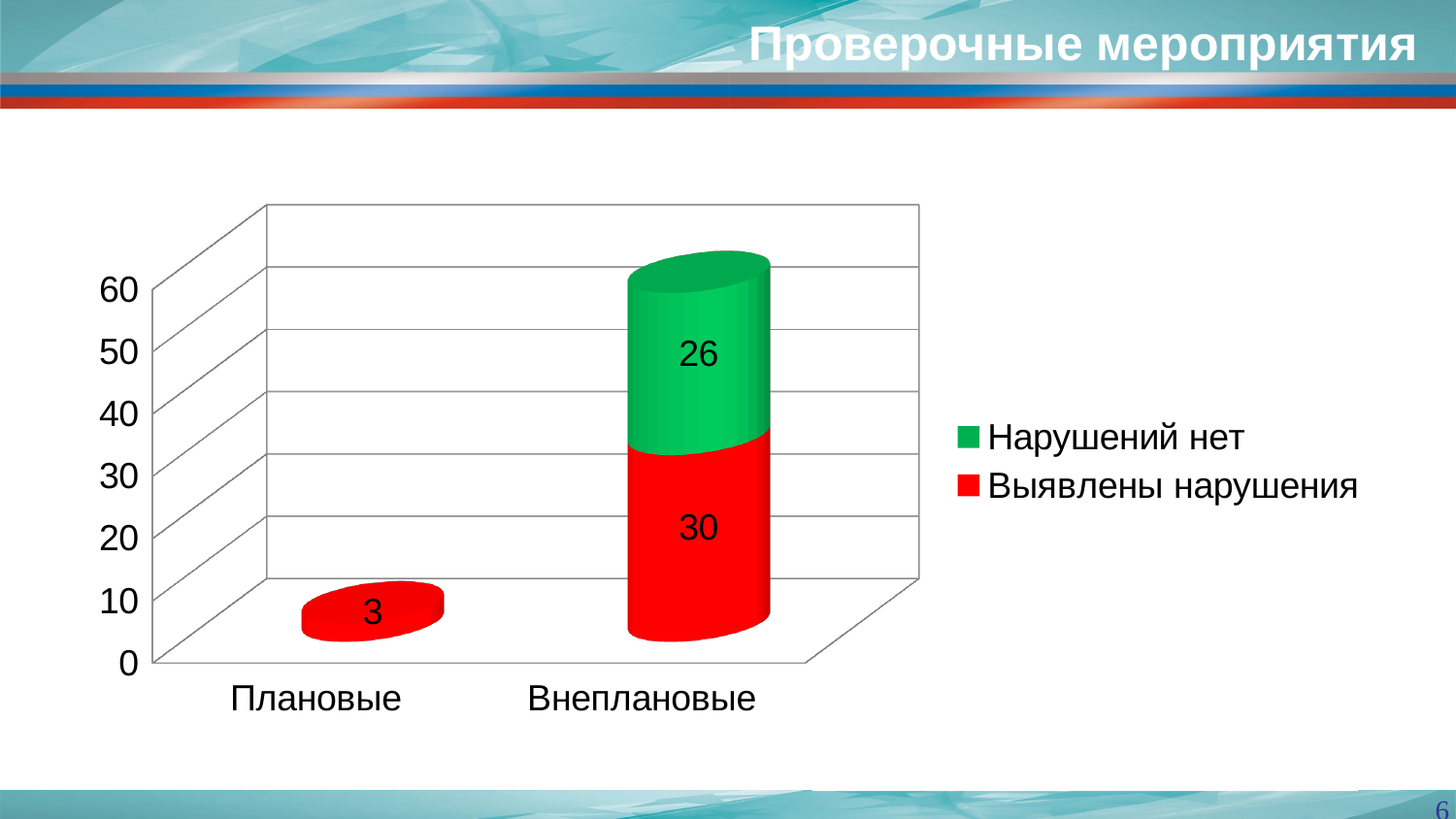
What is the value for "Нарушений нет" in the "Внеплановые" category? 26 What kind of chart is shown on the slide? Stacked bar chart Which category has the higher value for "Выявлены нарушения", "Плановые" or "Внеплановые"? Внеплановые How many series does the legend list? 2 Which colour represents "Нарушений нет" in the legend? Green What is the value for "Выявлены нарушения" in the "Плановые" category? 3 How many categories are shown on the x axis? 2 What is the value for "Выявлены нарушения" in the "Внеплановые" category? 30 Is the total for "Внеплановые" greater or less than 50? greater What is the total of the stacked bar for "Внеплановые"? 56 What is the difference between "Выявлены нарушения" and "Нарушений нет" in the "Внеплановые" category? 4 Which category has the lowest value for "Выявлены нарушения"? Плановые